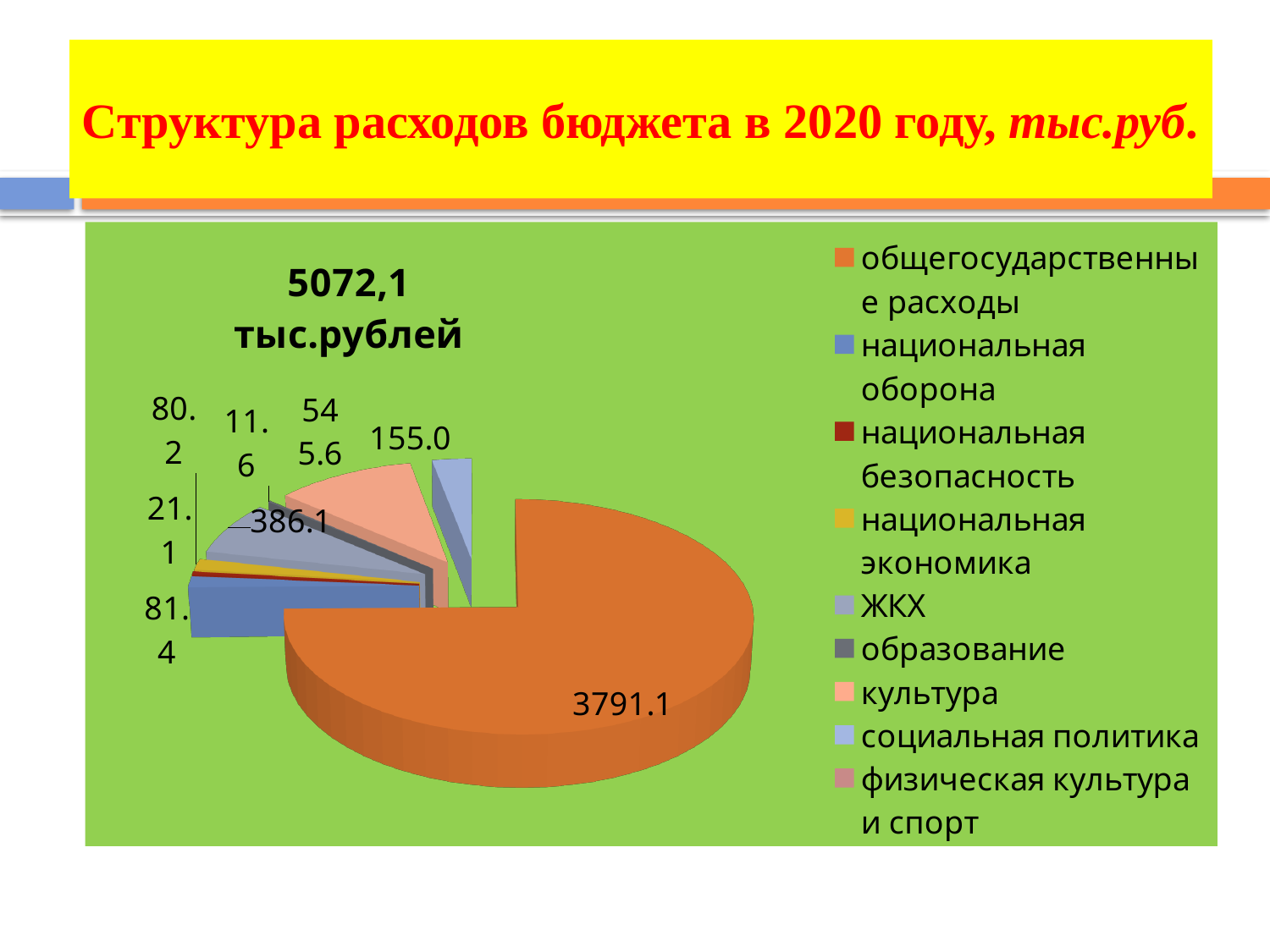
What is the value of the largest slice of the pie chart? 3791.1 What share of the total 5072,1 does the общегосударственные расходы slice (3791.1) represent? 74.7% How many categories does the legend of the pie chart list? 9 What is the value labelled for the социальная политика slice? 155.0 What is the value labelled for the культура slice? 545.6 What is the difference between the общегосударственные расходы value and the культура value? 3245.5 What kind of chart is shown on the slide? pie chart What is the title shown above the pie chart? 5072,1 тыс.рублей What is the smallest value printed as a data label on the pie chart? 11.6 Which category has the largest slice of the pie chart? общегосударственные расходы What is the value labelled for the национальная оборона slice? 81.4 Which is larger, the культура slice or the национальная оборона slice? культура